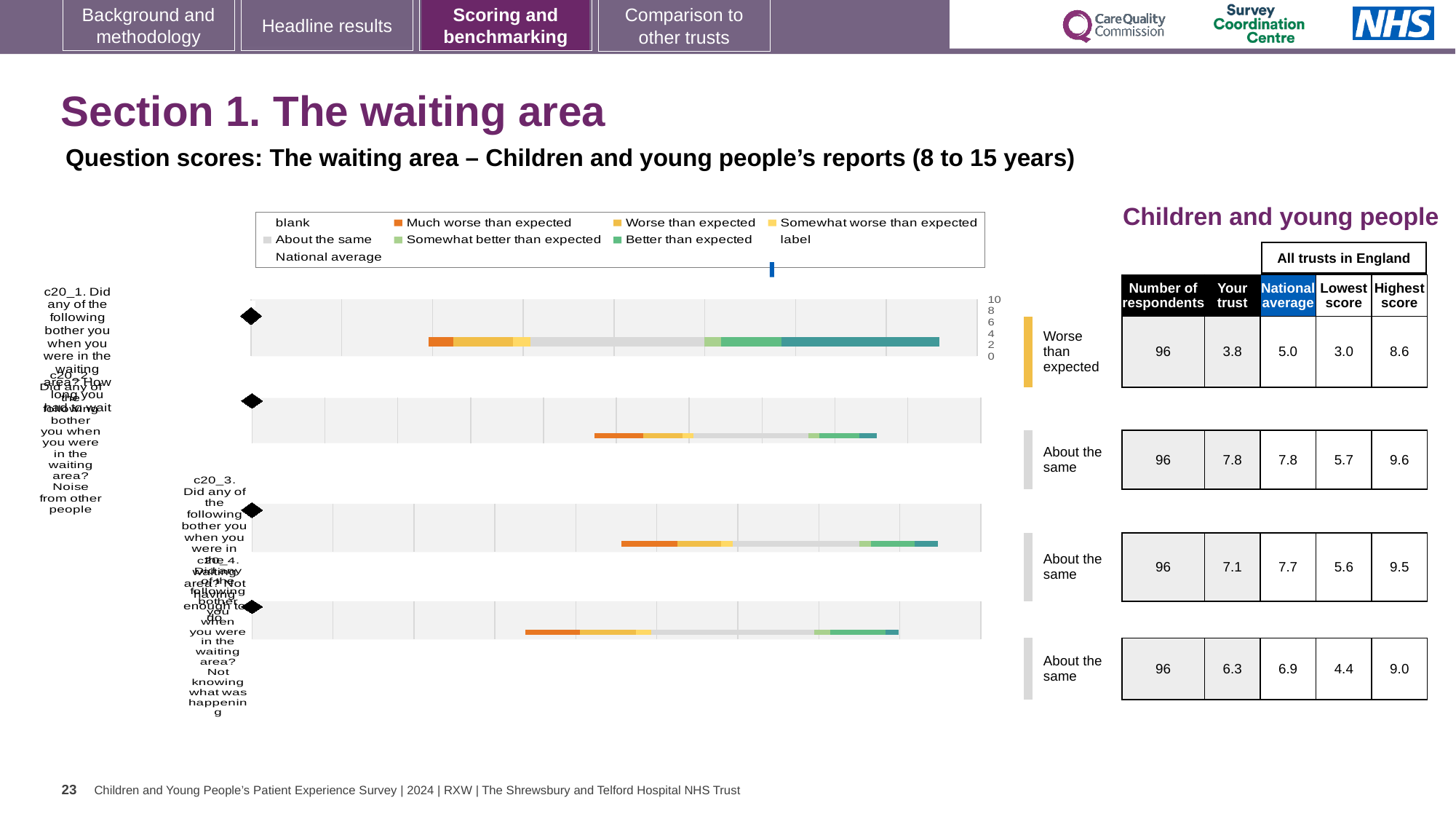
In the table next to the chart, what is the highest score for the fourth question (c20_4)? 9.0 What rating label is shown beside the first bar (c20_1)? Worse than expected What rating label is shown beside the second bar (c20_2)? About the same What does the legend call the category shown in light grey? About the same In the table next to the chart, which question has the lowest 'Your trust' score? c20_1 Which colour does the legend use for 'Much worse than expected'? orange In the table next to the chart, what is the difference between the national average and the 'Your trust' score for the third question (c20_3)? 0.6 How many respondents are listed for each question in the table next to the chart? 96 How many question bars are plotted in the chart? 4 What kind of chart is shown on the slide? bar chart In the table next to the chart, what is the 'Your trust' score for the first question (c20_1)? 3.8 In the table next to the chart, what is the national average for the second question (c20_2)? 7.8